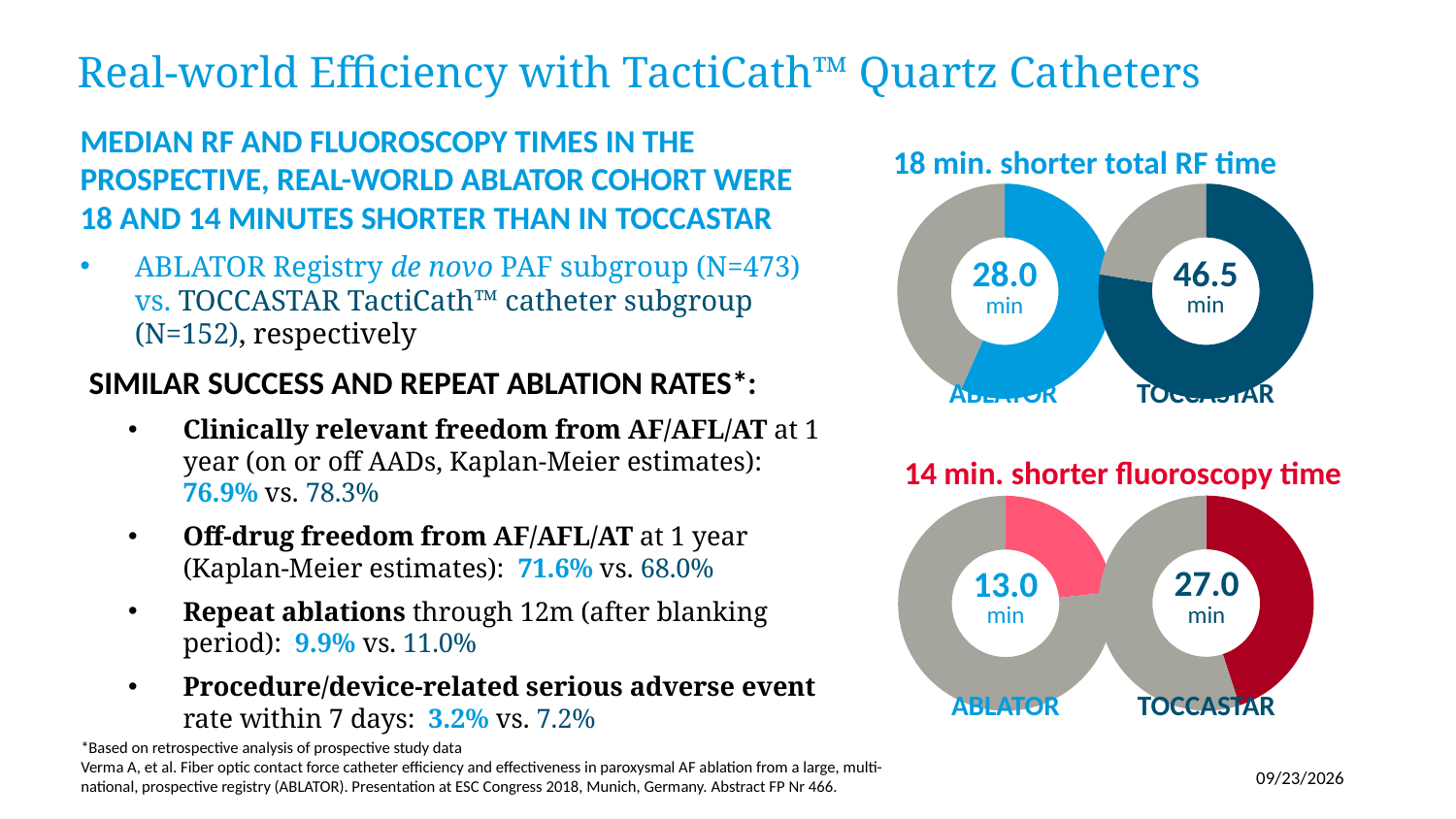
How many donut charts are shown on the slide? 4 In the '18 min. shorter total RF time' chart, what is the value shown for TOCCASTAR? 46.5 min Across all four donut charts, which chart and cohort shows the lowest value? ABLATOR in the fluoroscopy time chart (13.0 min) What kind of chart is used to display the RF and fluoroscopy times on the slide? Donut (pie) chart In the '18 min. shorter total RF time' chart, what is the value shown for ABLATOR? 28.0 min In the '14 min. shorter fluoroscopy time' chart, which cohort has the smaller value, ABLATOR or TOCCASTAR? ABLATOR In the '14 min. shorter fluoroscopy time' chart, what is the difference between the TOCCASTAR and ABLATOR values? 14.0 min In the '14 min. shorter fluoroscopy time' chart, what is the value shown for TOCCASTAR? 27.0 min What is the title of the upper pair of donut charts? 18 min. shorter total RF time In the '14 min. shorter fluoroscopy time' chart, what colour is the TOCCASTAR segment? Dark red In the '14 min. shorter fluoroscopy time' chart, what is the value shown for ABLATOR? 13.0 min In the '18 min. shorter total RF time' chart, which cohort has the larger value, ABLATOR or TOCCASTAR? TOCCASTAR